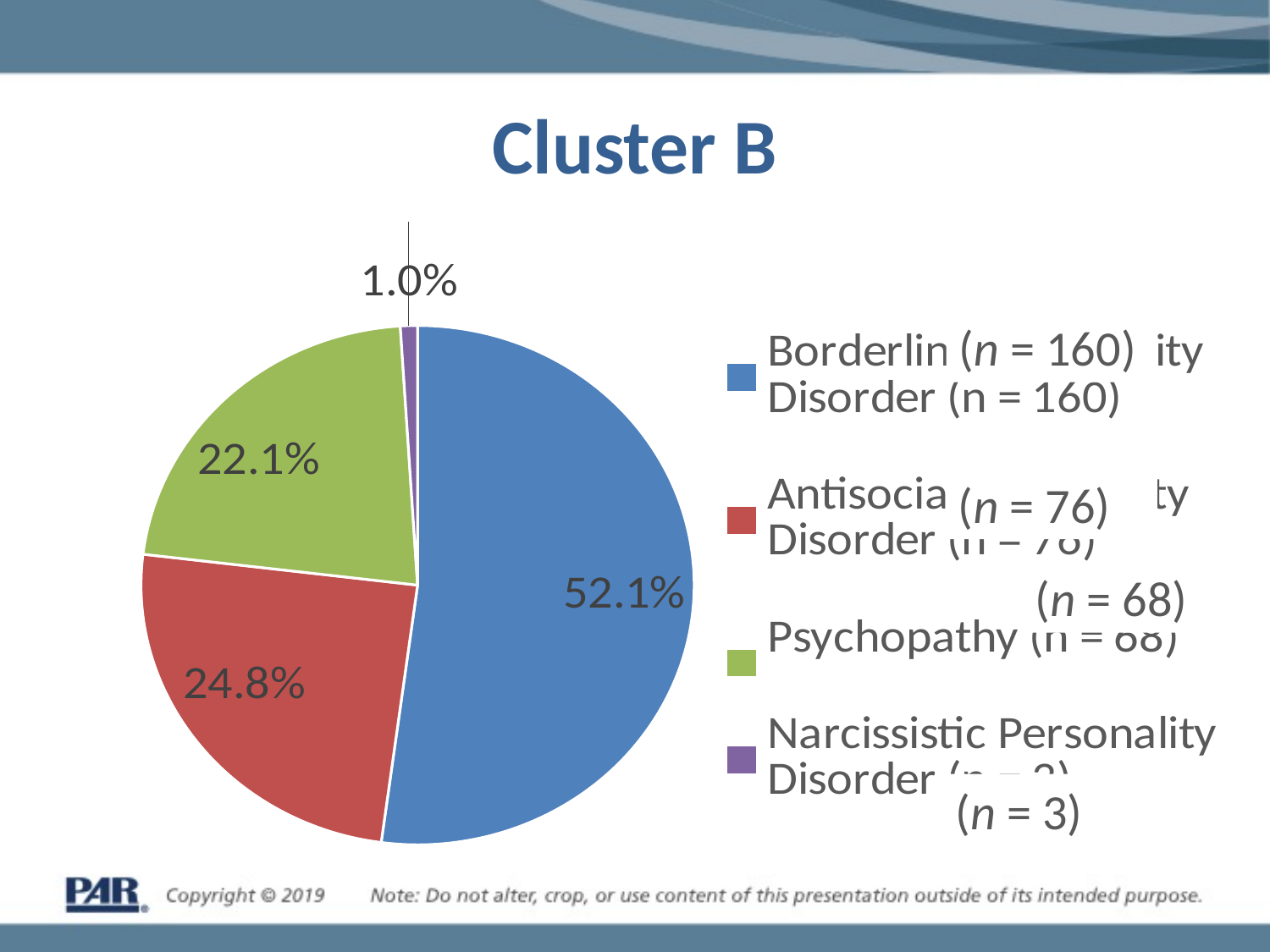
Which category has the smallest share of the pie? Narcissistic Personality Disorder Which category has the largest share of the pie? Borderline Personality Disorder Which is larger, the share for Antisocial Personality Disorder or the share for Psychopathy? Antisocial Personality Disorder What percentage of the pie is Narcissistic Personality Disorder? 1.0% What type of chart is shown on the slide? pie chart What is the title of the chart? Cluster B What colour is the Psychopathy slice? green What percentage of the pie is Borderline Personality Disorder? 52.1% How many slices does the pie chart have? 4 What percentage of the pie is Psychopathy? 22.1% What percentage of the pie is Antisocial Personality Disorder? 24.8% What is the difference in percentage points between Borderline Personality Disorder and Antisocial Personality Disorder? 27.3%